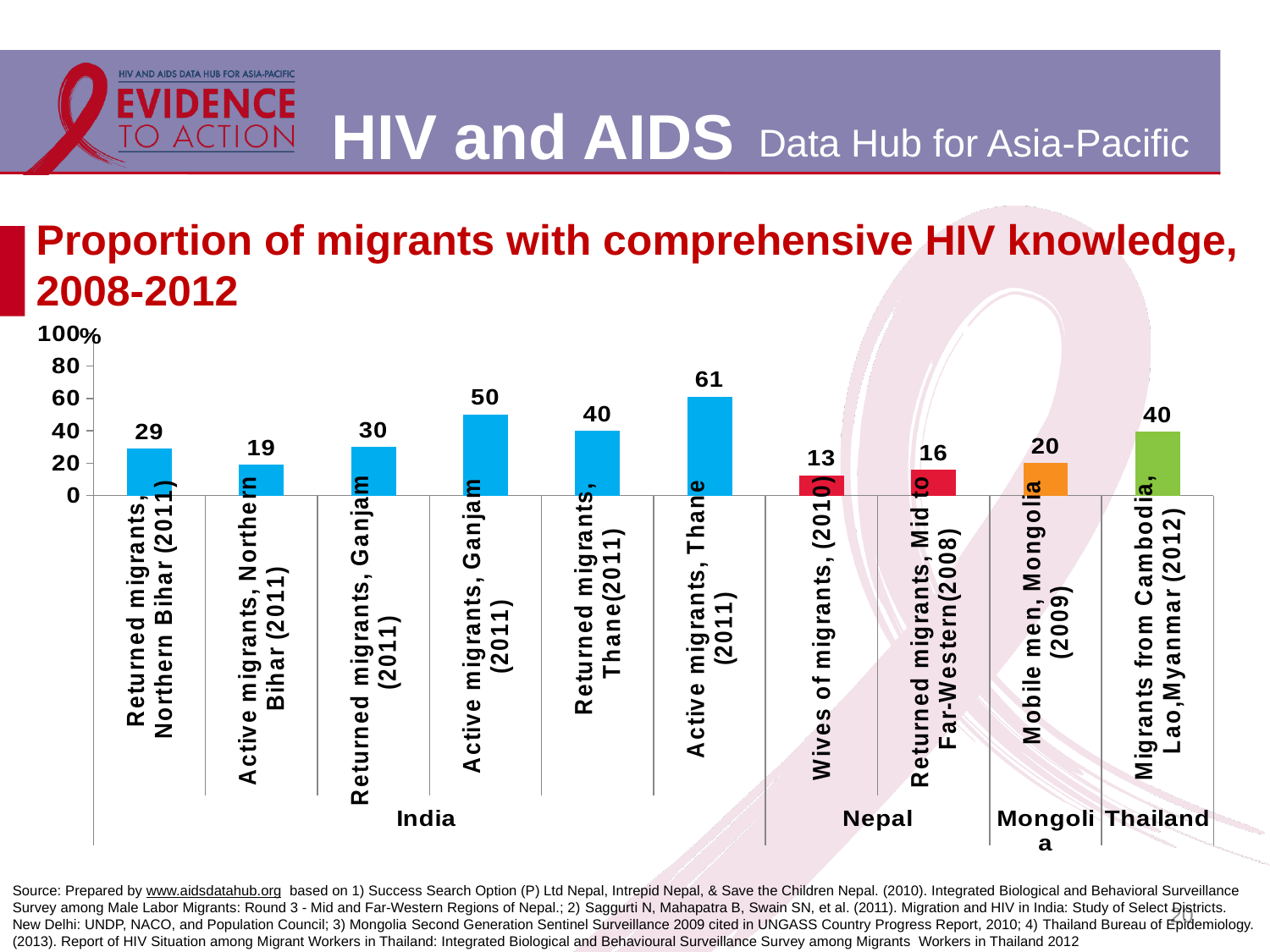
What is the difference between Returned migrants, Mid to Far-Western (2008) and Wives of migrants (2010)? 3 What is the value for Returned migrants, Ganjam (2011)? 30 What is the value for Mobile men, Mongolia (2009)? 20 What kind of chart is shown on the slide? Bar chart What is the value for Active migrants, Thane (2011)? 61 Which is larger: Returned migrants, Northern Bihar (2011) or Active migrants, Northern Bihar (2011)? Returned migrants, Northern Bihar (2011) What is the value for Wives of migrants (2010) in Nepal? 13 How many bars are plotted in the chart? 10 Which category has the highest value? Active migrants, Thane (2011) What is the difference between Active migrants, Ganjam (2011) and Returned migrants, Ganjam (2011)? 20 Which country group contains the most bars in the chart? India Which category has the lowest value? Wives of migrants (2010)